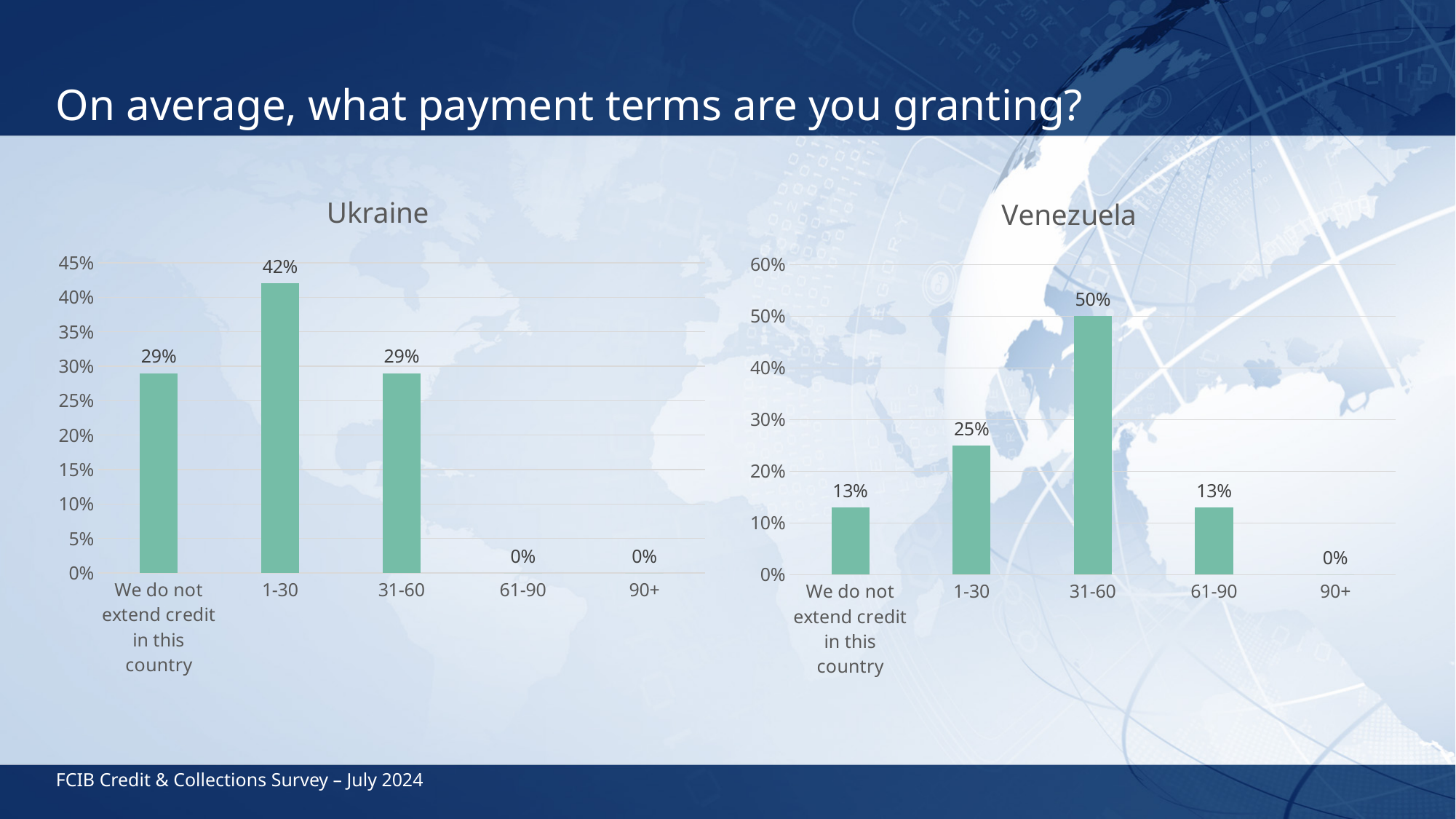
What kind of chart is the Venezuela chart? Bar chart In the Ukraine chart, what is the value for 1-30? 42% In the Venezuela chart, which category has the lowest value? 90+ In the Venezuela chart, which is larger, the value for 1-30 or the value for 61-90? 1-30 In the Ukraine chart, what is the value for 'We do not extend credit in this country'? 29% In the Venezuela chart, what is the value for 31-60? 50% In the Ukraine chart, which category has the highest value? 1-30 In the Ukraine chart, what is the difference between the values for 1-30 and 31-60? 13% In the Venezuela chart, what is the difference between the values for 31-60 and 61-90? 37% In the Venezuela chart, which category has the highest value? 31-60 How many categories are shown on the x axis of the Ukraine chart? 5 In the Venezuela chart, what is the value for 1-30? 25%